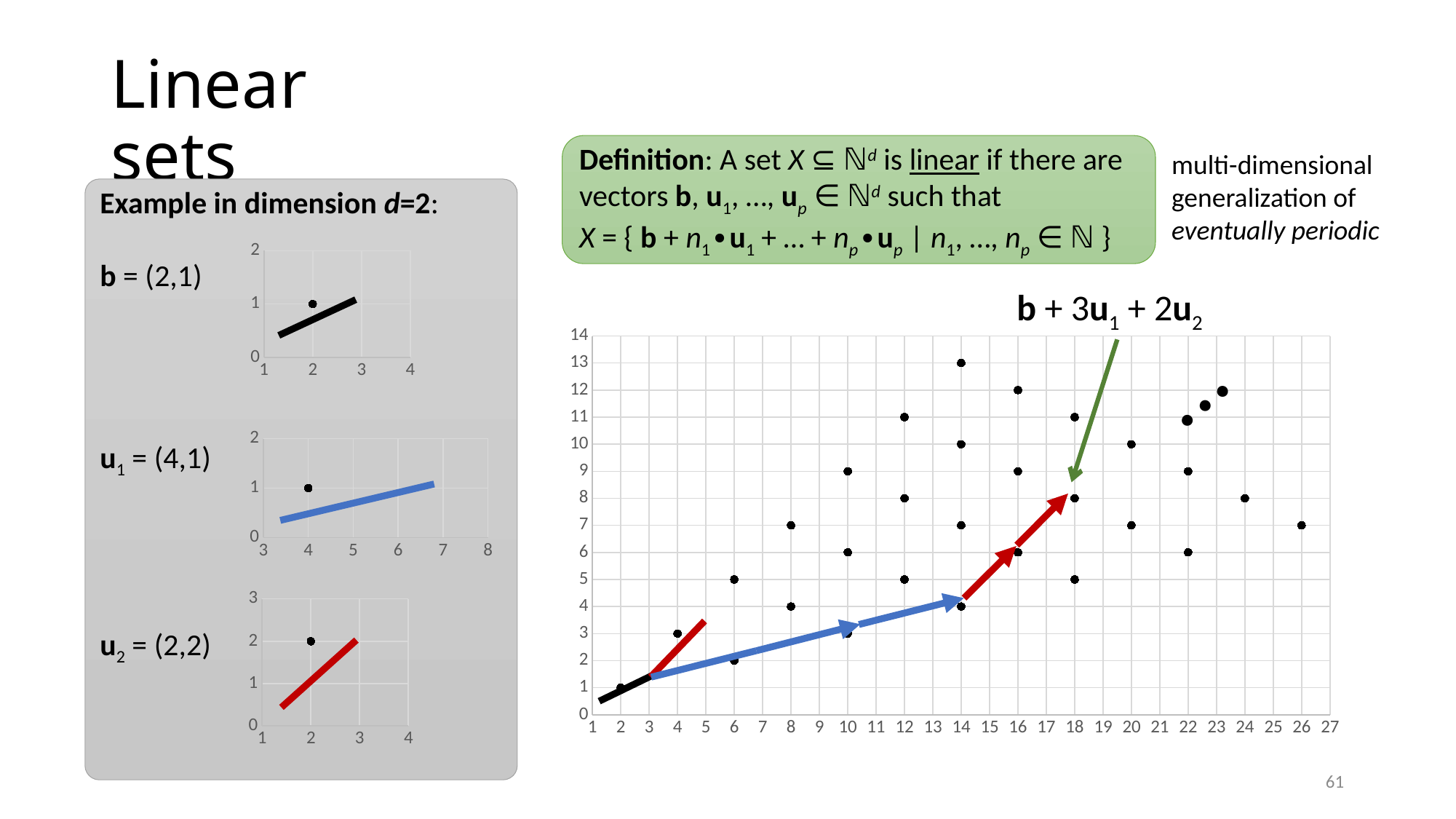
On the large chart on the right, what is the y-value of the point at x = 26? 7 On the small chart next to the label u1 = (4,1), what is the y-value of the plotted point? 1 On the large chart on the right, what is the y-value of the lowest plotted point? 1 On the small chart next to the label b = (2,1), at what x-value is the plotted point? 2 On the large chart on the right, what is the x-value of the highest plotted point? 14 On the large chart on the right, what is the y-value of the highest plotted point? 13 On the small chart next to the label u2 = (2,2), what is the highest value shown on the vertical axis? 3 What kind of chart is the large chart on the right of the slide? scatter chart On the large chart on the right, what is the highest value shown on the vertical axis? 14 On the large chart on the right, what is the x-value of the leftmost plotted point? 2 On the large chart on the right, is the y-value of the point at x = 26 greater or less than 10? less On the large chart on the right, what is the largest value labelled on the horizontal axis? 27